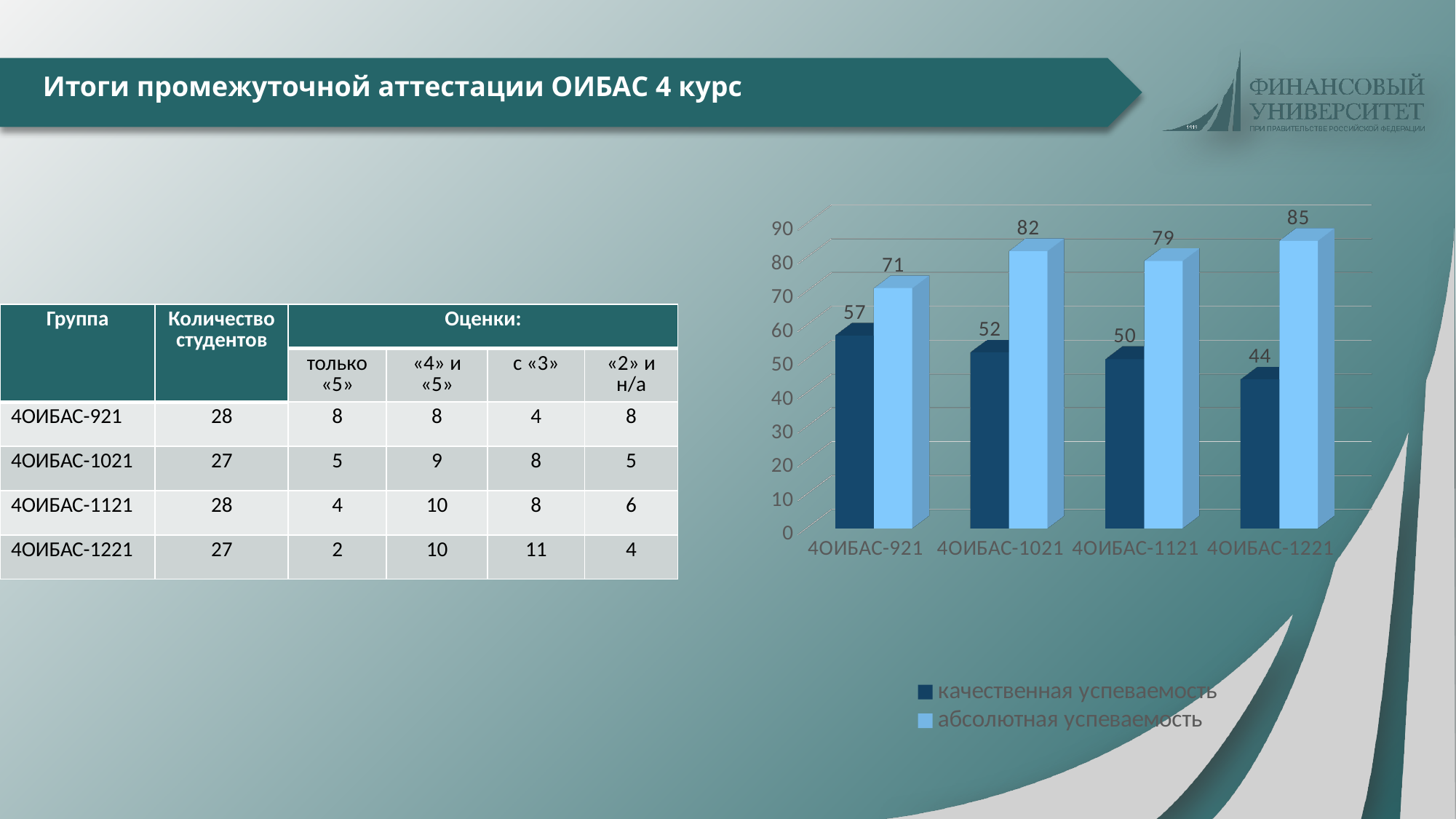
How many series does the chart legend list? 2 Which is larger: качественная успеваемость for 4ОИБАС-921 or for 4ОИБАС-1021? 4ОИБАС-921 Which series is shown in light blue in the chart legend? абсолютная успеваемость What is the difference between абсолютная успеваемость and качественная успеваемость for 4ОИБАС-1121? 29 Does качественная успеваемость rise or fall from 4ОИБАС-921 to 4ОИБАС-1221? fall What is the value of качественная успеваемость for 4ОИБАС-921? 57 Which group has the lowest качественная успеваемость? 4ОИБАС-1221 Which group has the highest абсолютная успеваемость? 4ОИБАС-1221 What is the value of абсолютная успеваемость for 4ОИБАС-1221? 85 What is the value of абсолютная успеваемость for 4ОИБАС-1021? 82 What kind of chart is shown on the slide? bar chart How many groups are shown on the x axis of the chart? 4